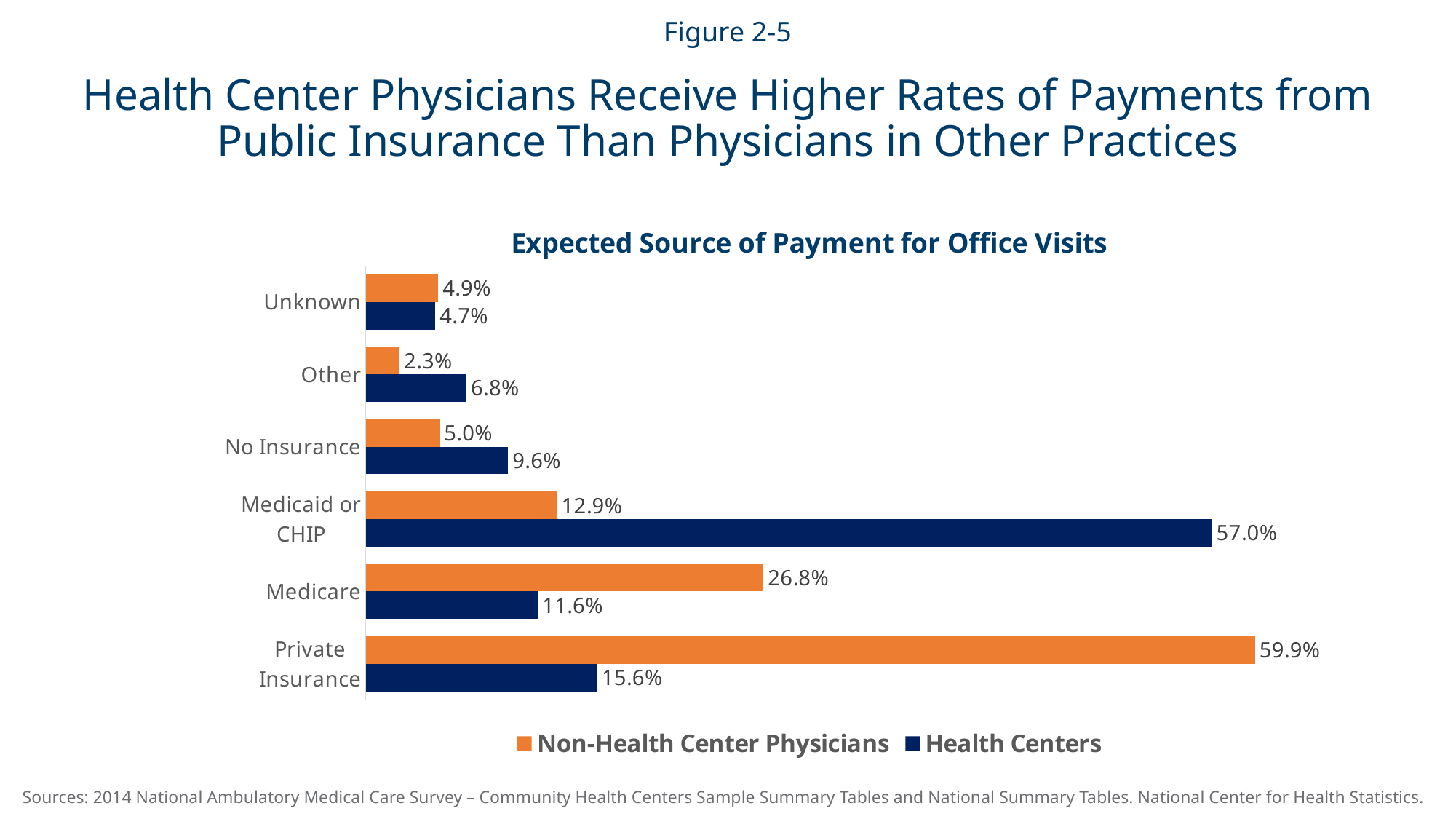
Which category has the highest Health Centers value? Medicaid or CHIP Which category has the lowest Non-Health Center Physicians value? Other What kind of chart is shown on the slide? Bar chart What is the Non-Health Center Physicians value for Private Insurance? 59.9% How many series does the legend list? 2 How many payment source categories are shown on the chart? 6 What is the difference between the Health Centers and Non-Health Center Physicians values for Medicaid or CHIP? 44.1% What is the title of the chart? Expected Source of Payment for Office Visits What is the Health Centers value for Medicaid or CHIP? 57.0% For Medicare, which series has the larger value: Non-Health Center Physicians or Health Centers? Non-Health Center Physicians What is the Health Centers value for No Insurance? 9.6% What is the Non-Health Center Physicians value for Medicare? 26.8%